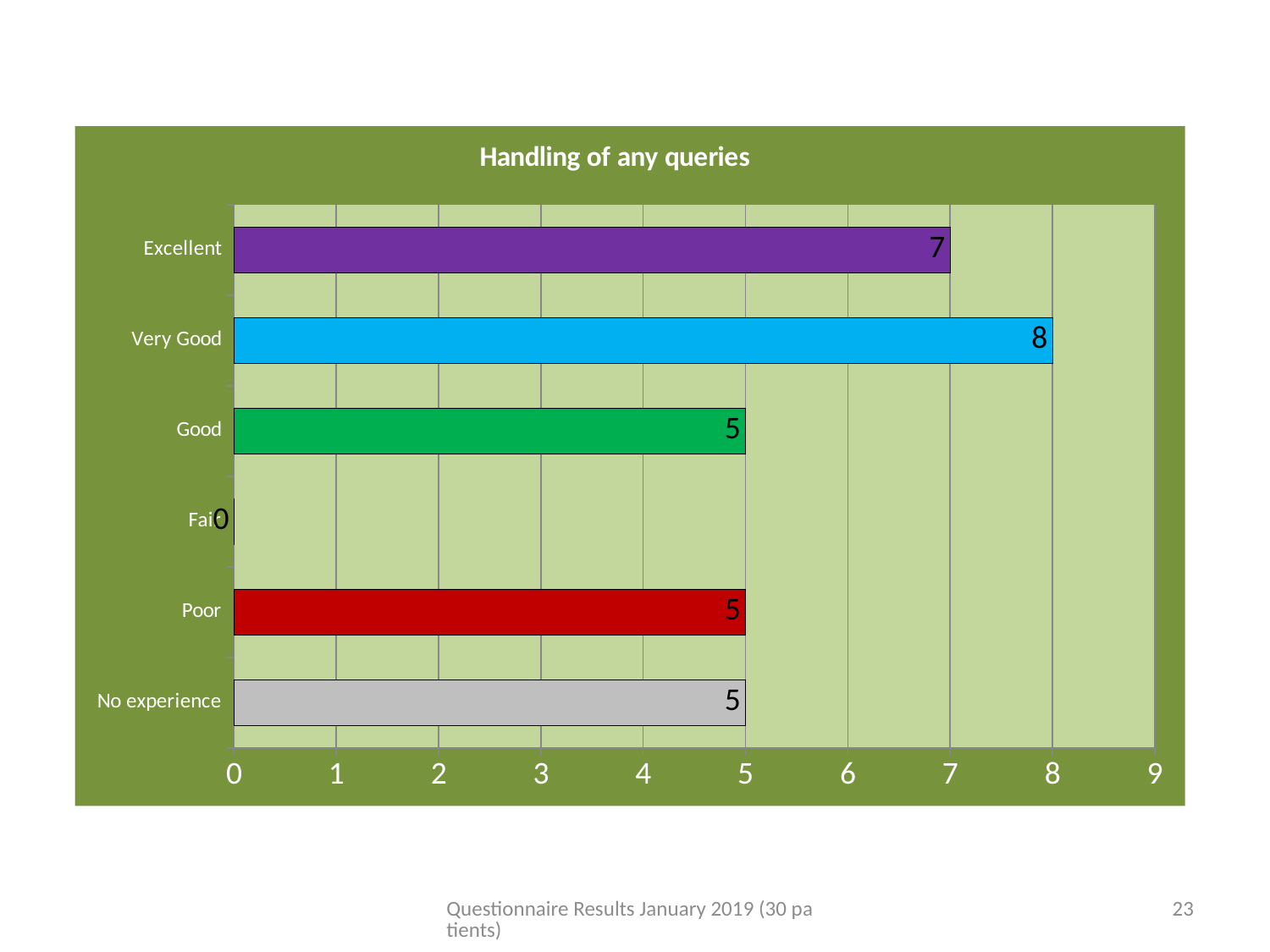
Which is larger, the value for Excellent or the value for Very Good? Very Good How many categories are shown in the chart? 6 What is the value for Very Good? 8 What kind of chart is shown on the slide? Bar chart What is the value for No experience? 5 What is the value for Fair? 0 What is the difference between the values for Very Good and Excellent? 1 What is the difference between the values for Excellent and Good? 2 What is the value for Excellent in the Handling of any queries chart? 7 Which category has the highest value? Very Good What is the title of the chart? Handling of any queries Which category has the lowest value? Fair